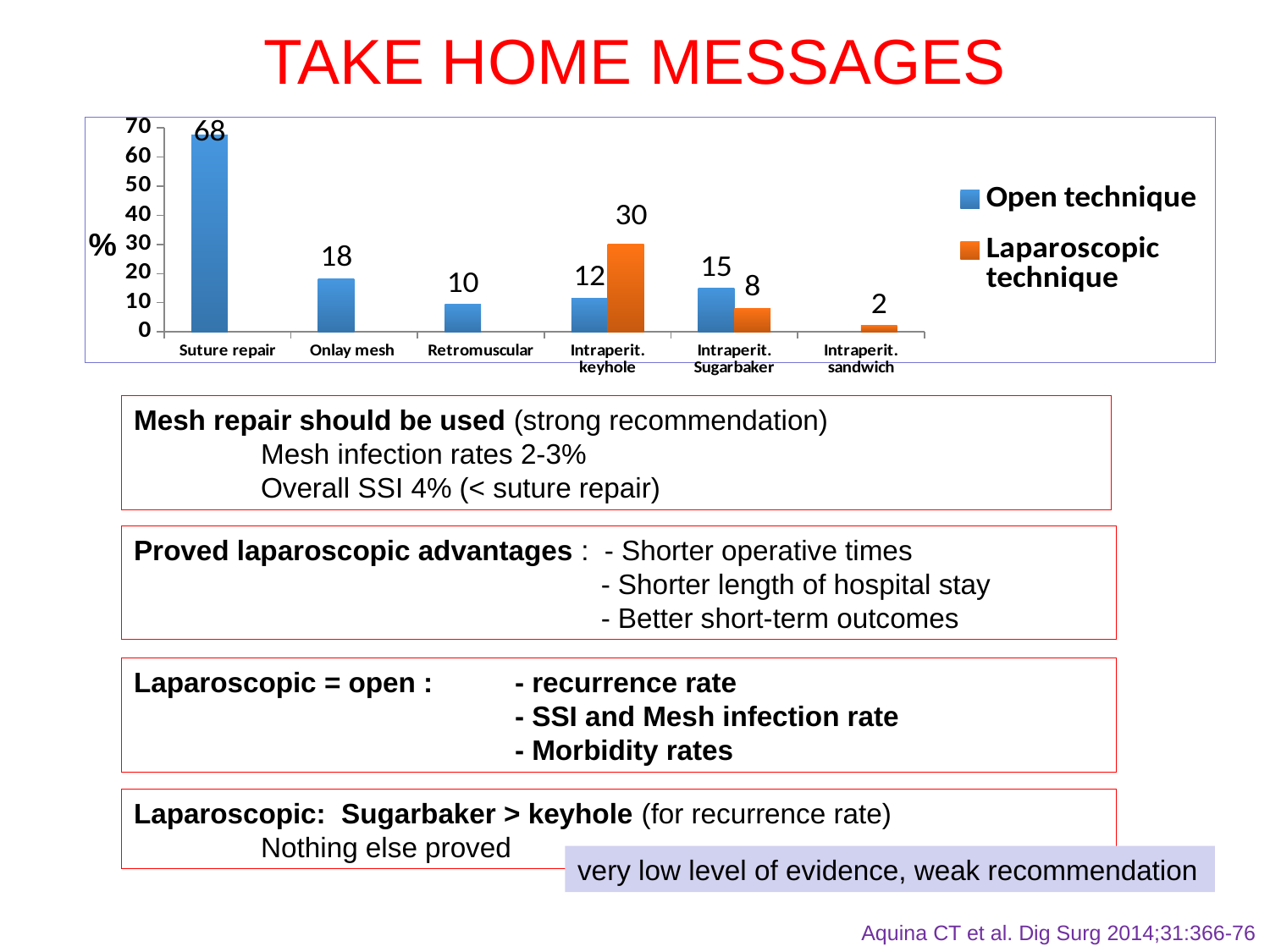
What is the value for Suture repair with the Open technique? 68 What is the value for Intraperit. Sugarbaker with the Open technique? 15 For Intraperit. keyhole, which technique has the larger value, Open or Laparoscopic? Laparoscopic technique Is the Open technique value for Retromuscular greater or less than 20? less How many categories are shown on the x axis? 6 What is the difference between the Open technique values for Suture repair and Onlay mesh? 50 What is the value for Intraperit. keyhole with the Laparoscopic technique? 30 What is the value for Intraperit. sandwich with the Laparoscopic technique? 2 Which category has the highest value for the Open technique? Suture repair What kind of chart is shown on the slide? Bar chart Which category has the lowest value for the Laparoscopic technique? Intraperit. sandwich How many series does the legend list? 2